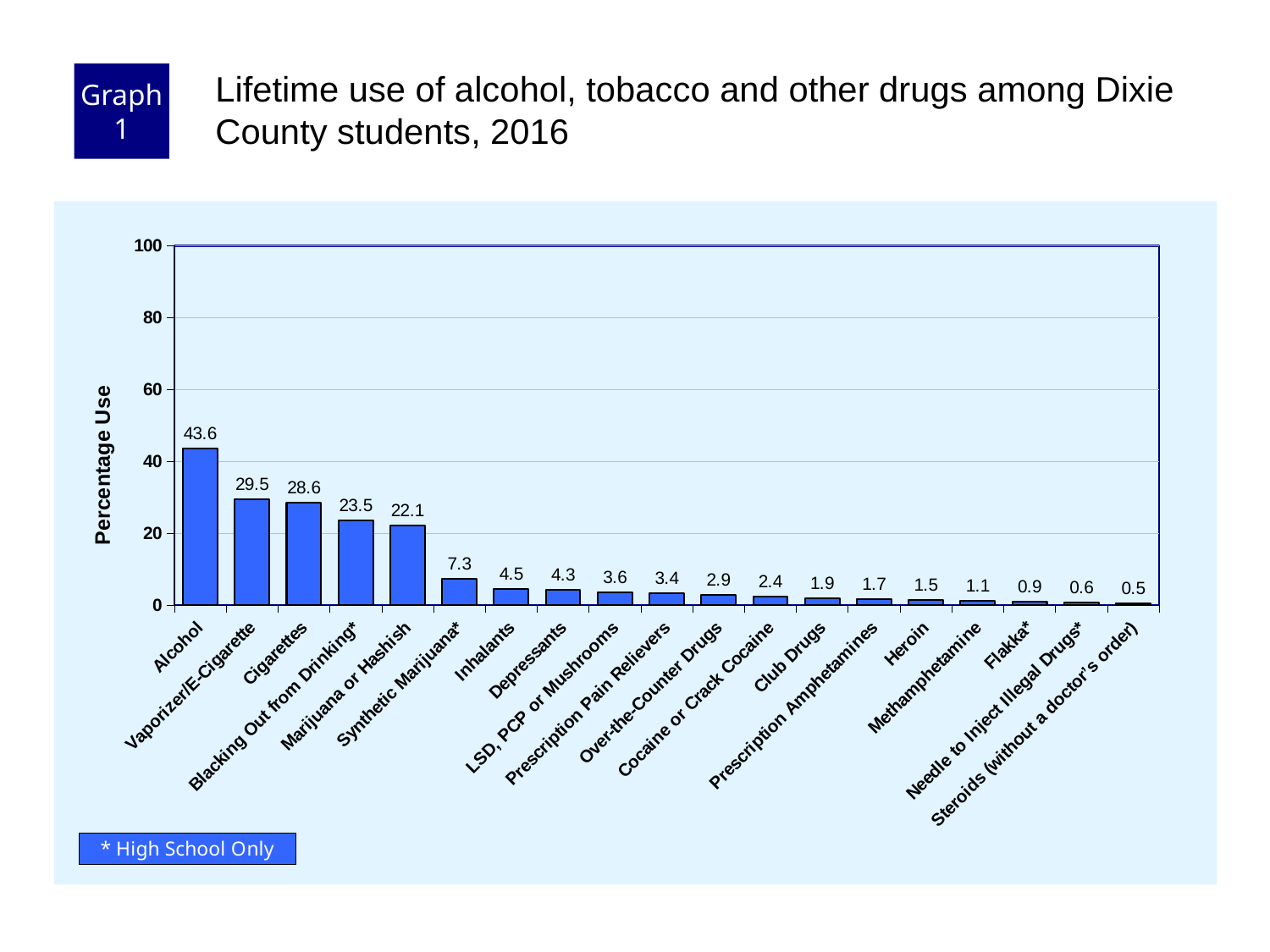
What is the value for Alcohol? 43.6 What is the label of the y axis? Percentage Use Is the value for Alcohol greater or less than 40? greater What is the difference between the values for Vaporizer/E-Cigarette and Blacking Out from Drinking*? 6 What is the value for Heroin? 1.5 What kind of chart is shown on the slide? bar chart Which category has the highest value? Alcohol What is the difference between the values for Alcohol and Cigarettes? 15 Which is larger, the value for Inhalants or the value for Synthetic Marijuana*? Synthetic Marijuana* How many categories are shown on the chart? 19 What is the value for Marijuana or Hashish? 22.1 Which category has the lowest value? Steroids (without a doctor's order)